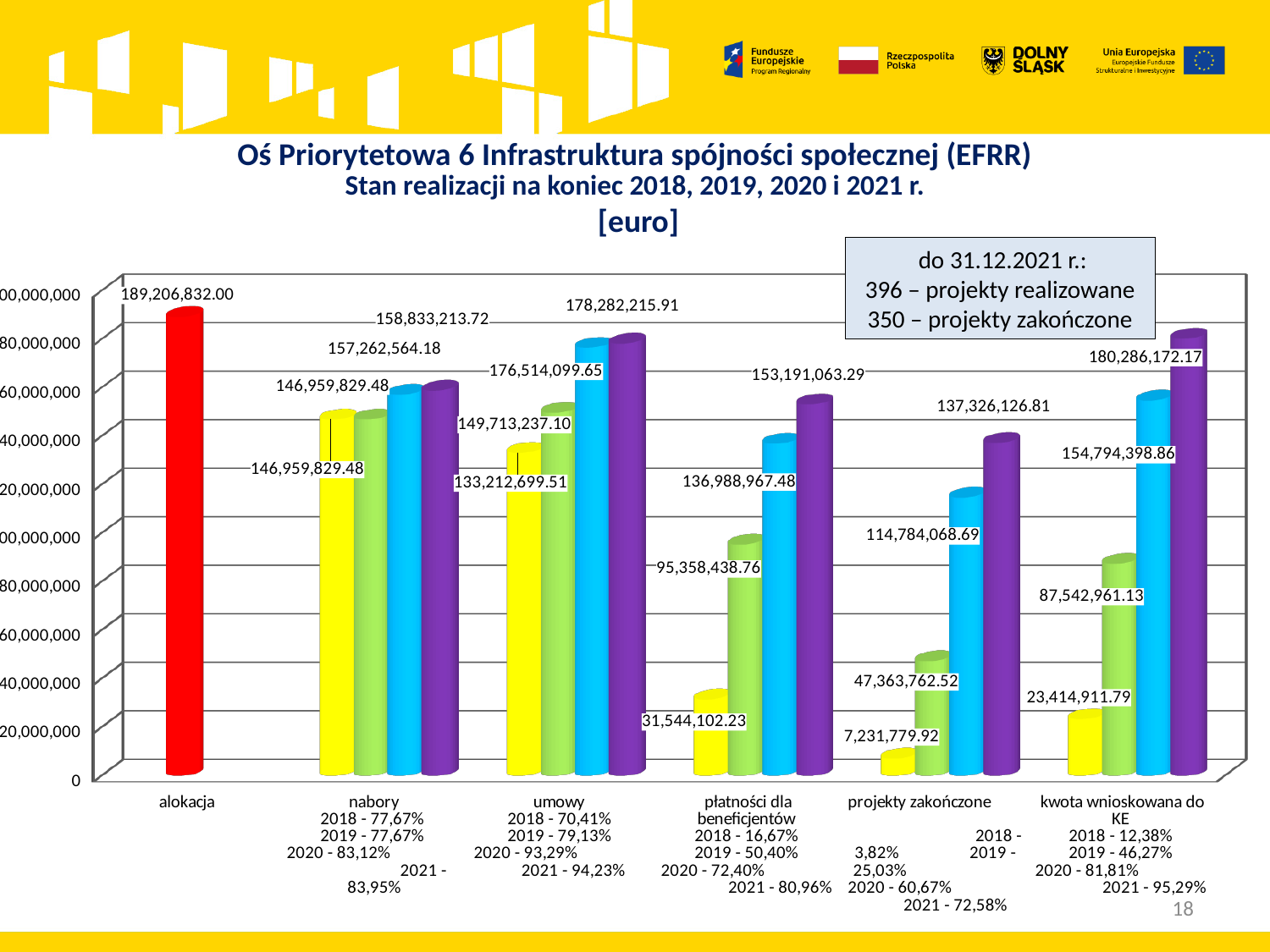
Which category has the lowest yellow bar? projekty zakończone According to the text box, how many projekty zakończone were there as of 31.12.2021? 350 What is the value of the alokacja bar? 189,206,832.00 Which is larger: the blue bar in projekty zakończone or the blue bar in kwota wnioskowana do KE? kwota wnioskowana do KE How many categories are shown on the x axis? 6 What is the value of the purple bar in the umowy group? 178,282,215.91 Is the value of the green bar in the kwota wnioskowana do KE group greater or less than 100,000,000? less What is the difference between the purple bar and the yellow bar in the płatności dla beneficjentów group? 121,646,961.06 What is the value of the yellow bar in the projekty zakończone group? 7,231,779.92 Within the płatności dla beneficjentów group, do the bars rise or fall from left to right? rise What kind of chart is shown on the slide? bar chart What is the value of the blue bar in the kwota wnioskowana do KE group? 154,794,398.86